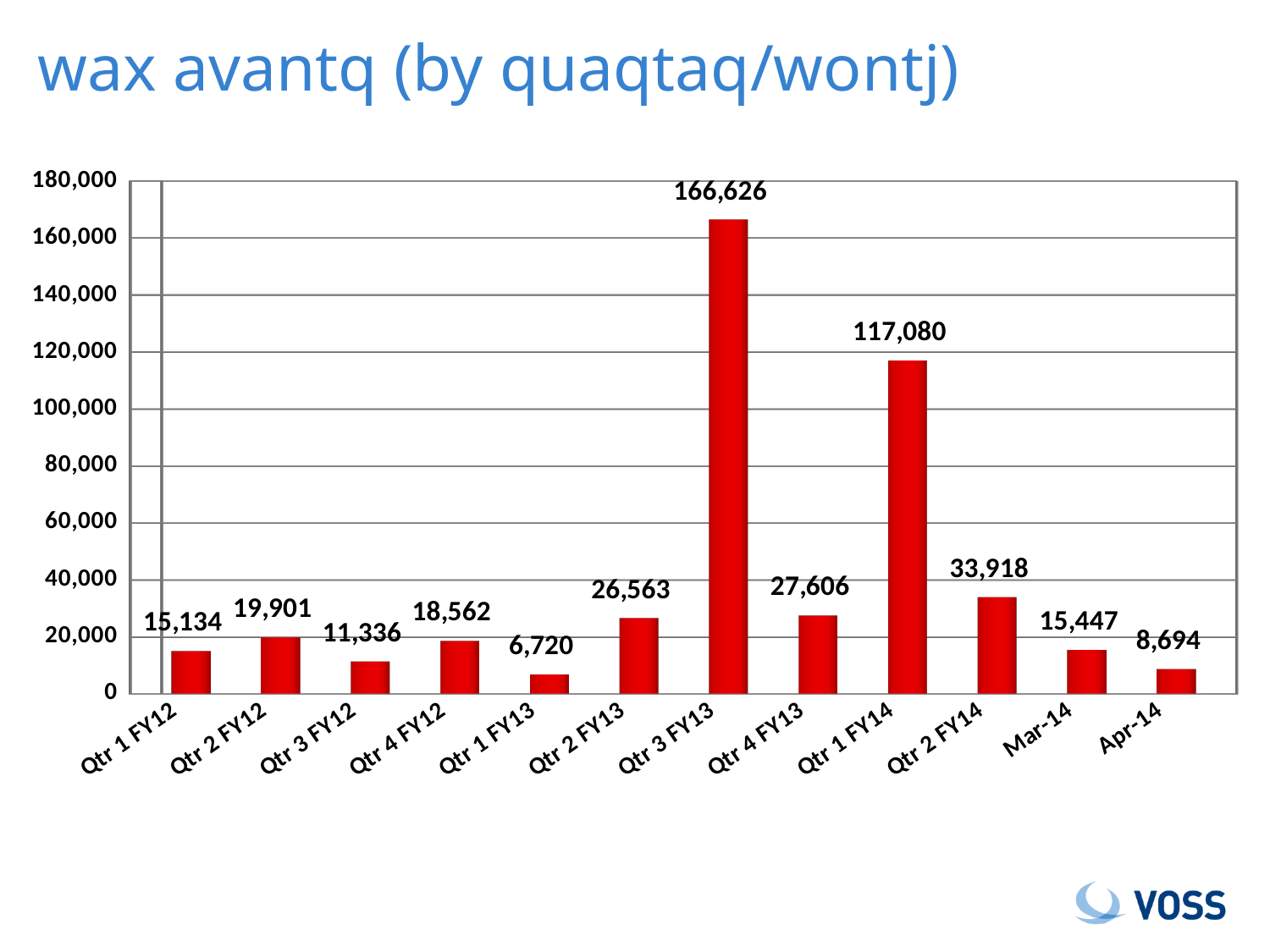
What is the difference between the values for Qtr 3 FY13 and Qtr 1 FY14? 49,546 How many categories are shown on the x axis? 12 Which is larger, the value for Qtr 2 FY13 or the value for Qtr 4 FY13? Qtr 4 FY13 What is the value for Apr-14? 8,694 What kind of chart is shown on the slide? bar chart What is the value for Qtr 1 FY14? 117,080 Which category has the highest value? Qtr 3 FY13 What is the title of the slide? wax avantq (by quaqtaq/wontj) Which category has the lowest value? Qtr 1 FY13 What is the value for Qtr 2 FY14? 33,918 What is the value for Qtr 3 FY13? 166,626 Is the value for Qtr 2 FY14 greater or less than 40,000? less